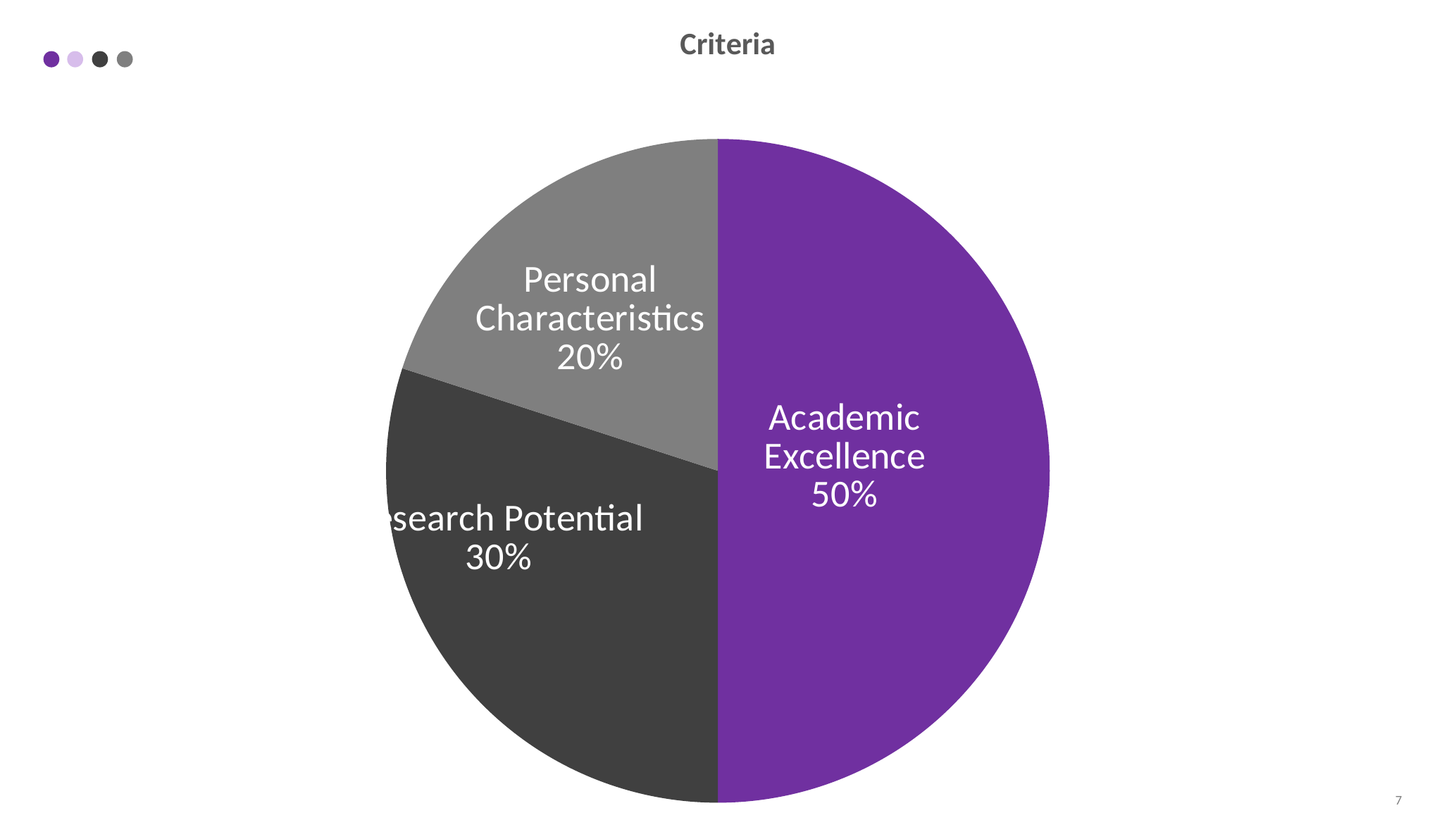
What type of chart is shown on the slide? pie chart What colour is the Academic Excellence slice? purple What is the difference in percentage points between Academic Excellence and Research Potential? 20% How many slices does the pie chart have? 3 Which slice of the pie is the largest? Academic Excellence What is the title of the chart? Criteria Which is larger, Research Potential or Personal Characteristics? Research Potential Which slice of the pie is the smallest? Personal Characteristics What share of the pie does Research Potential represent? 30% What is the difference in percentage points between Research Potential and Personal Characteristics? 10% What share of the pie does Academic Excellence represent? 50% What share of the pie does Personal Characteristics represent? 20%